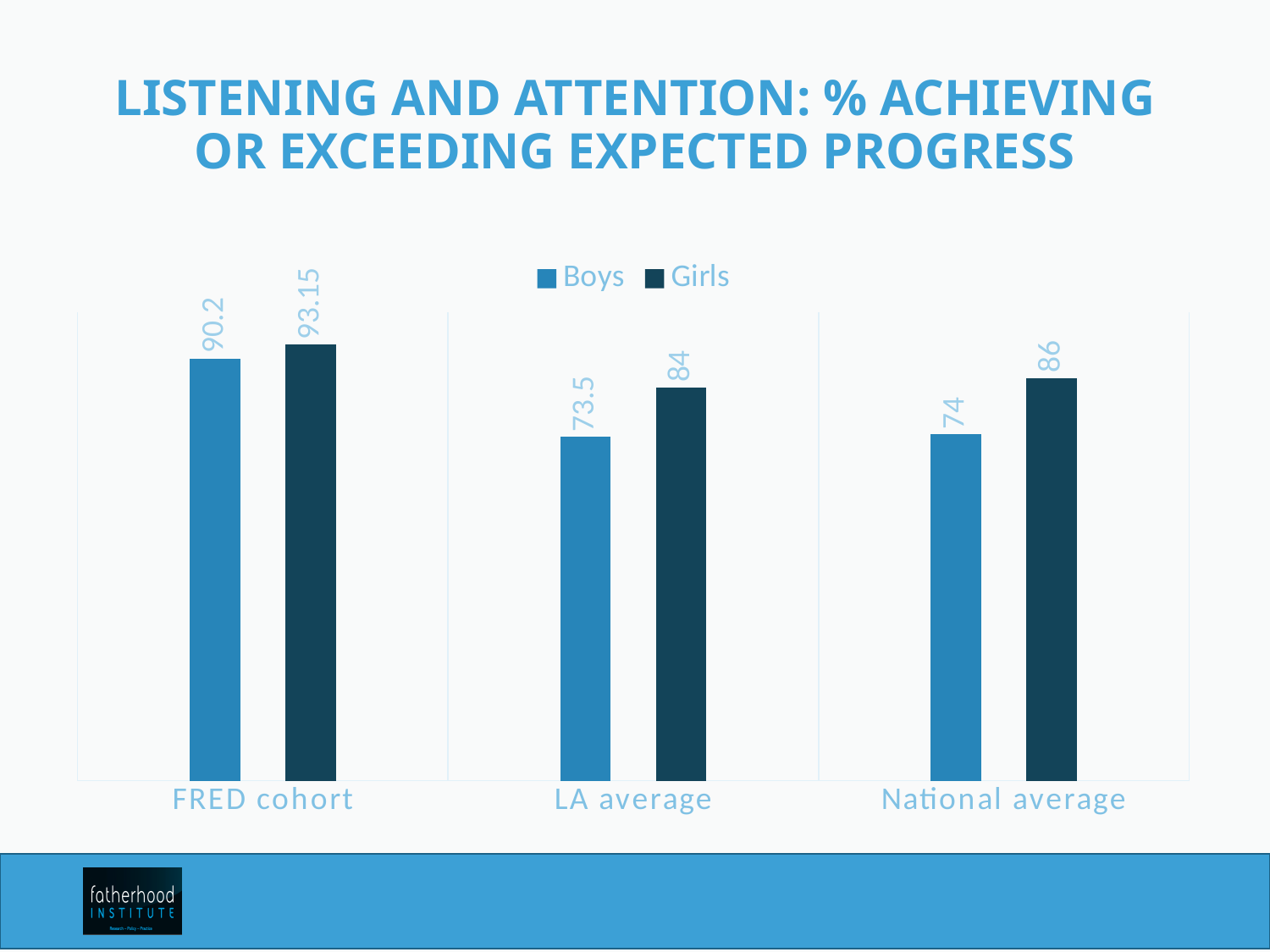
Which category has the highest value for Girls? FRED cohort What is the difference between the Girls and Boys values in the LA average? 10.5 What is the value for Girls in the FRED cohort? 93.15 Which is larger: the Girls value for the LA average or the Girls value for the National average? National average What is the difference between the Boys values for the FRED cohort and the National average? 16.2 Which category has the lowest value for Boys? LA average What kind of chart is shown on the slide? Bar chart How many categories are shown on the x axis? 3 What is the value for Girls in the National average? 86 What is the value for Boys in the LA average? 73.5 How many series does the legend list? 2 What is the value for Boys in the FRED cohort? 90.2